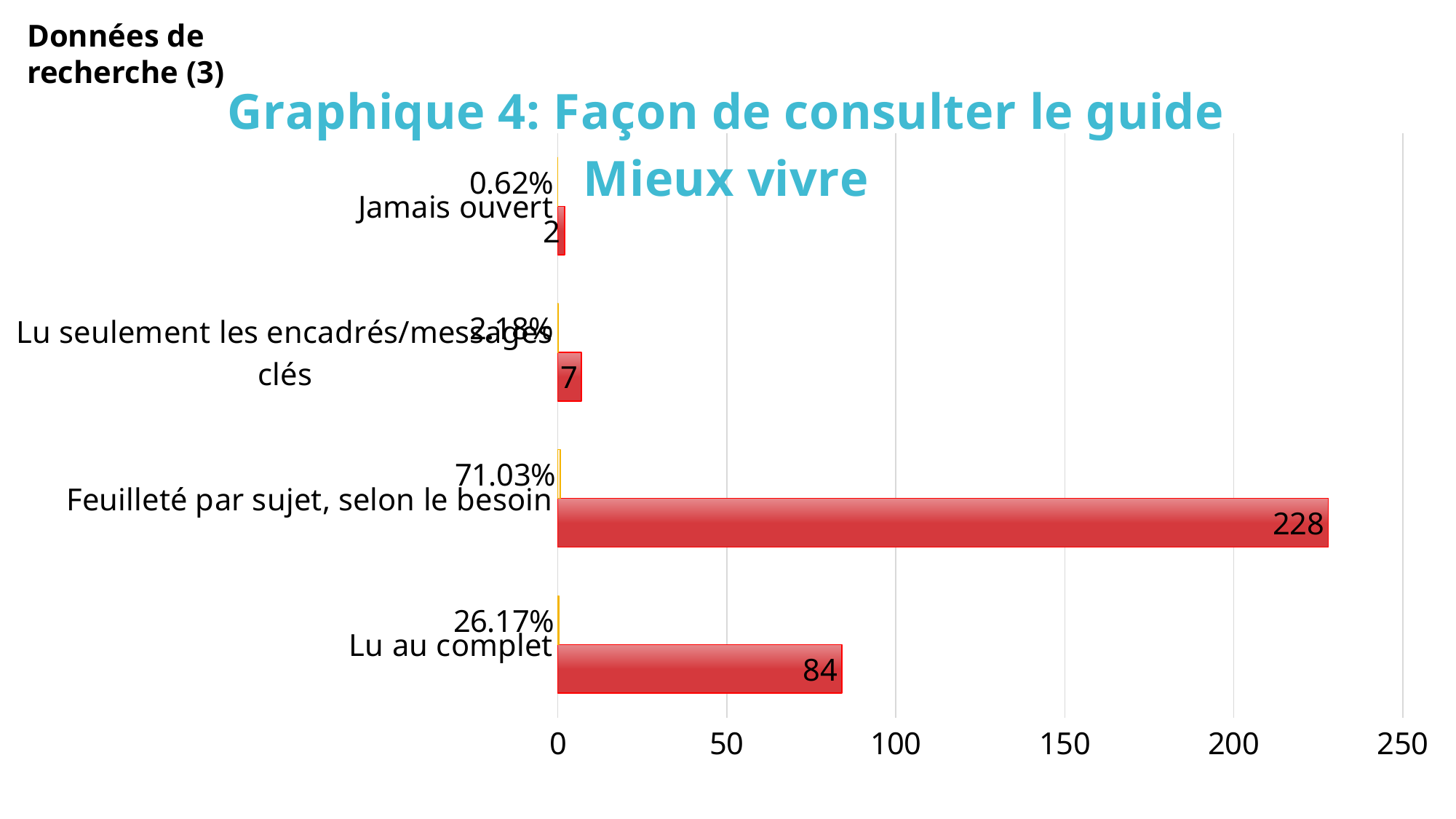
What percentage is shown for "Lu au complet"? 26.17% What is the count value for "Jamais ouvert"? 2 Which category has the lowest count? Jamais ouvert What percentage is shown for "Jamais ouvert"? 0.62% Which category has the highest count? Feuilleté par sujet, selon le besoin What type of chart is shown on the slide? Bar chart What is the count value for "Lu au complet"? 84 How many categories are shown on the chart? 4 What is the difference between the counts for "Feuilleté par sujet, selon le besoin" and "Lu au complet"? 144 What percentage is shown for "Feuilleté par sujet, selon le besoin"? 71.03% What is the count value for "Feuilleté par sujet, selon le besoin"? 228 Which has a larger count, "Lu au complet" or "Lu seulement les encadrés/messages clés"? Lu au complet